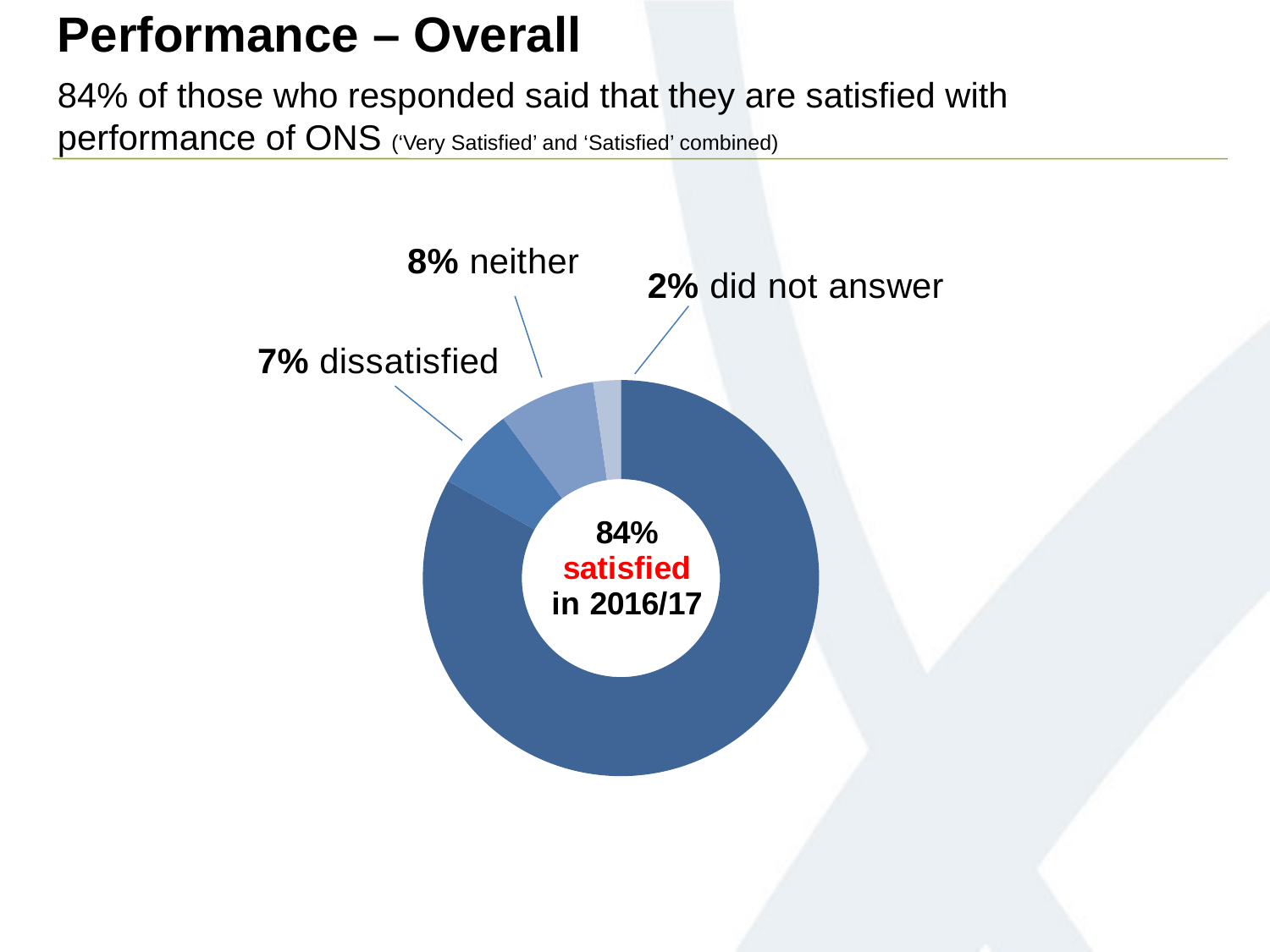
Which is larger, the share for 'neither' or the share for 'dissatisfied'? neither How many categories are shown in the chart? 4 Which category has the smallest share of the chart? did not answer What kind of chart is shown on the slide? doughnut (pie) chart Which category has the largest share of the chart? satisfied What percentage of respondents were dissatisfied? 7% What percentage of respondents answered 'neither'? 8% What is the difference in percentage points between the 'satisfied' and 'dissatisfied' shares? 77% What percentage of respondents were satisfied with the performance of ONS in 2016/17? 84% What is the difference in percentage points between the 'neither' and 'dissatisfied' shares? 1% What is the title of the slide containing the chart? Performance – Overall What percentage of respondents did not answer? 2%